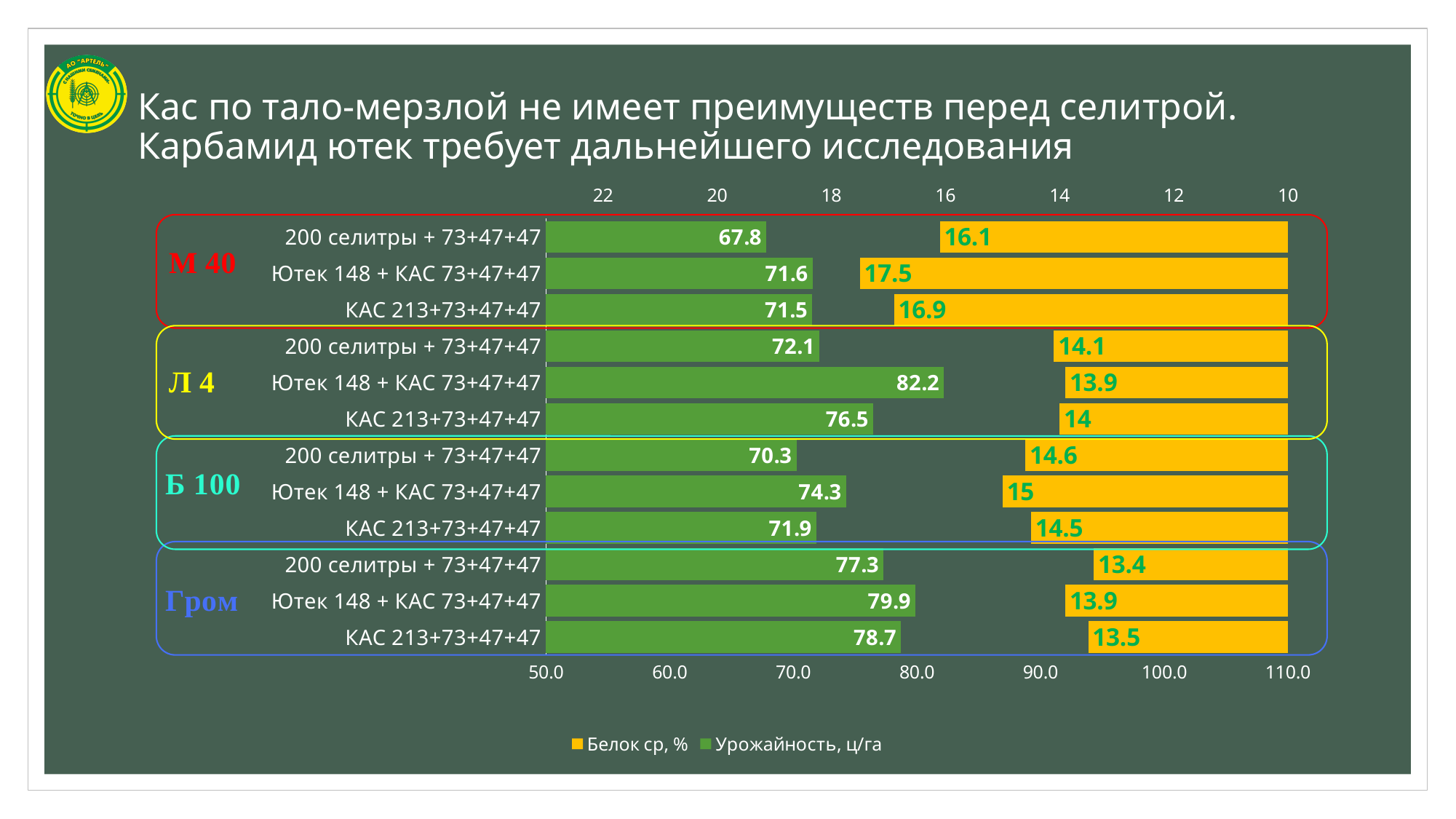
What is the difference in Урожайность, ц/га between Ютек 148 + КАС 73+47+47 and 200 селитры + 73+47+47 in the Л 4 group? 10.1 What is the Урожайность, ц/га value for 200 селитры + 73+47+47 in the Гром group? 77.3 In the Б 100 group, which has the higher Белок ср, % value: Ютек 148 + КАС 73+47+47 or 200 селитры + 73+47+47? Ютек 148 + КАС 73+47+47 What is the Белок ср, % value for Ютек 148 + КАС 73+47+47 in the М 40 group? 17.5 Which bar has the lowest Урожайность, ц/га value on the chart? 200 селитры + 73+47+47 (М 40) How many series does the legend list? 2 What type of chart is shown on the slide? Bar chart How many bars are plotted for the Урожайность, ц/га series? 12 What is the Белок ср, % value for КАС 213+73+47+47 in the Б 100 group? 14.5 Which bar has the lowest Белок ср, % value on the chart? 200 селитры + 73+47+47 (Гром) What is the Урожайность, ц/га value for Ютек 148 + КАС 73+47+47 in the Л 4 group? 82.2 Which bar has the highest Урожайность, ц/га value on the chart? Ютек 148 + КАС 73+47+47 (Л 4)